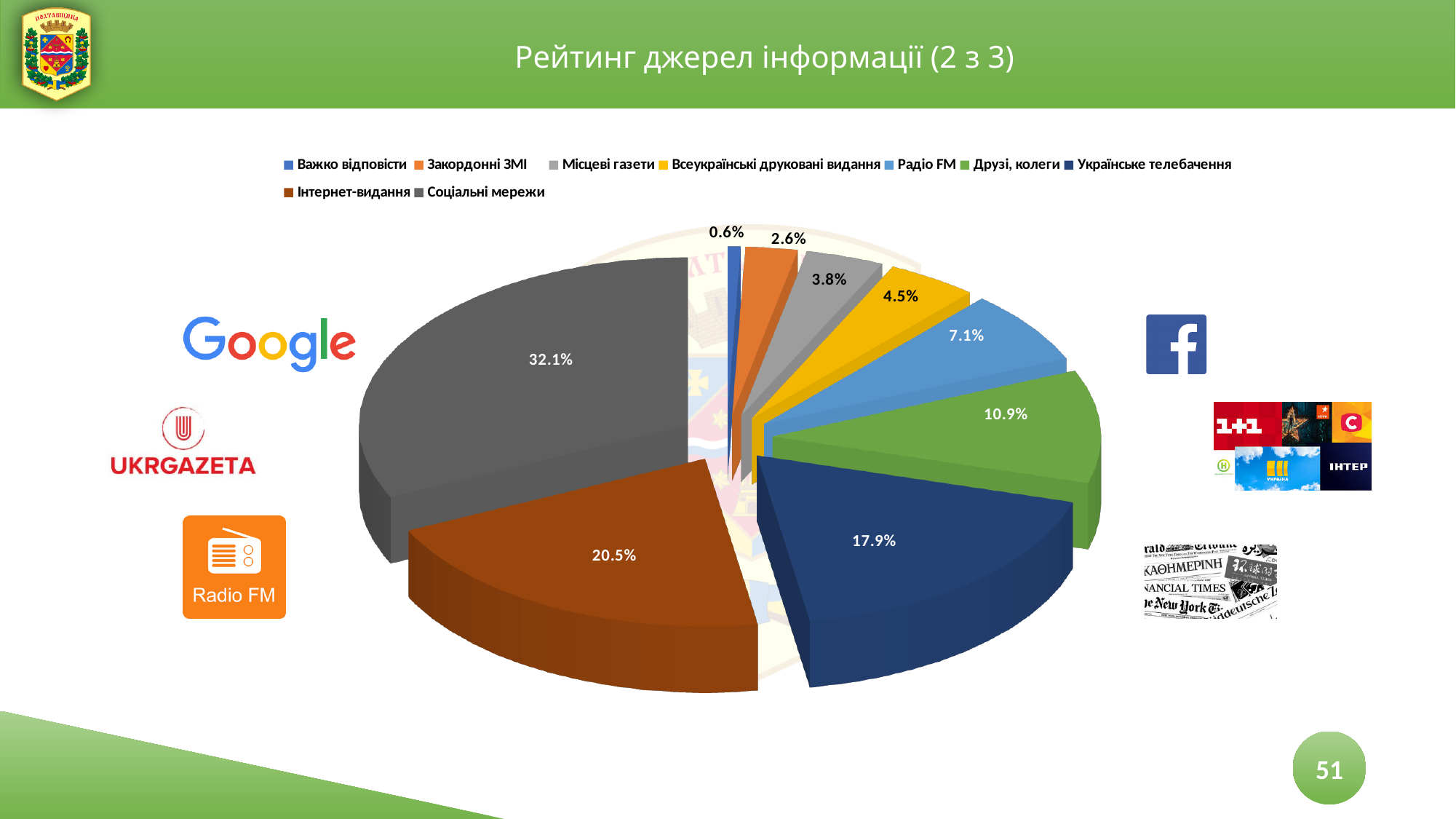
What is the title of the slide containing the chart? Рейтинг джерел інформації (2 з 3) What is the share for Важко відповісти? 0.6% How many categories does the pie chart have? 9 What kind of chart is shown on the slide? Pie chart What is the share for Соціальні мережі? 32.1% What is the difference between the shares for Інтернет-видання and Українське телебачення? 2.6% Which is larger, the share for Друзі, колеги or the share for Радіо FM? Друзі, колеги What is the share for Радіо FM? 7.1% What is the combined share of Місцеві газети and Всеукраїнські друковані видання? 8.3% Which category has the largest slice of the pie? Соціальні мережі Which category has the smallest slice of the pie? Важко відповісти What is the share for Українське телебачення? 17.9%